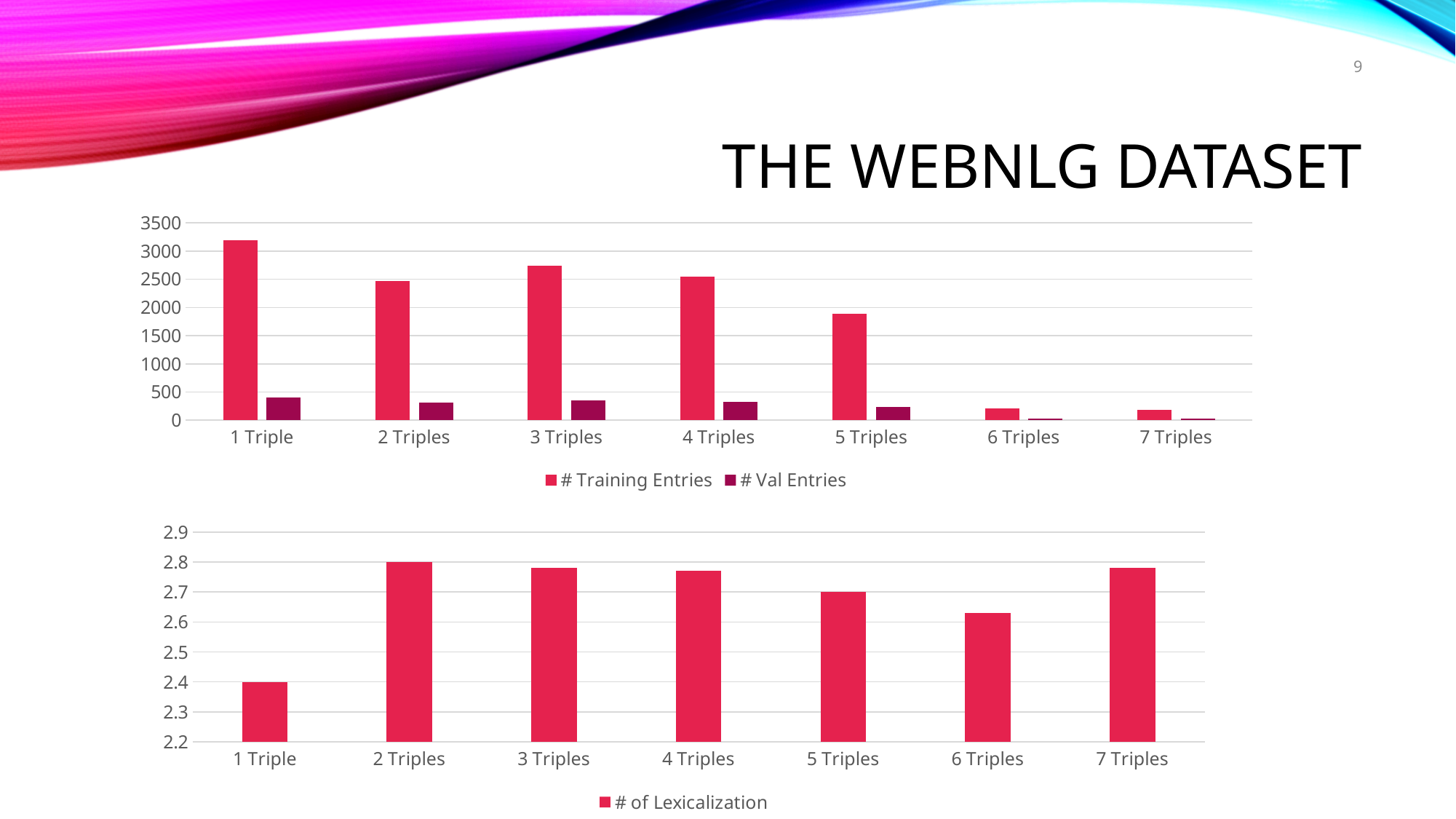
In the top chart, is the value for # Training Entries at 5 Triples greater or less than 2000? less In the top chart, which has more Training Entries: 2 Triples or 3 Triples? 3 Triples How many categories are shown on the x axis of the bottom chart? 7 In the top chart, which category has the highest number of Training Entries? 1 Triple What kind of chart is the top chart on the slide? bar chart In the top chart, is the value for # Training Entries at 1 Triple greater or less than 3000? greater In the bottom chart (# of Lexicalization), which category has the lowest value? 1 Triple In the bottom chart, what is the # of Lexicalization for 2 Triples? 2.8 In the top chart, do the # Training Entries values rise or fall from 4 Triples to 7 Triples? fall How many series does the legend of the top chart list? 2 In the top chart, is the value for # Val Entries at 1 Triple greater or less than 500? less In the bottom chart, what is the # of Lexicalization for 1 Triple? 2.4